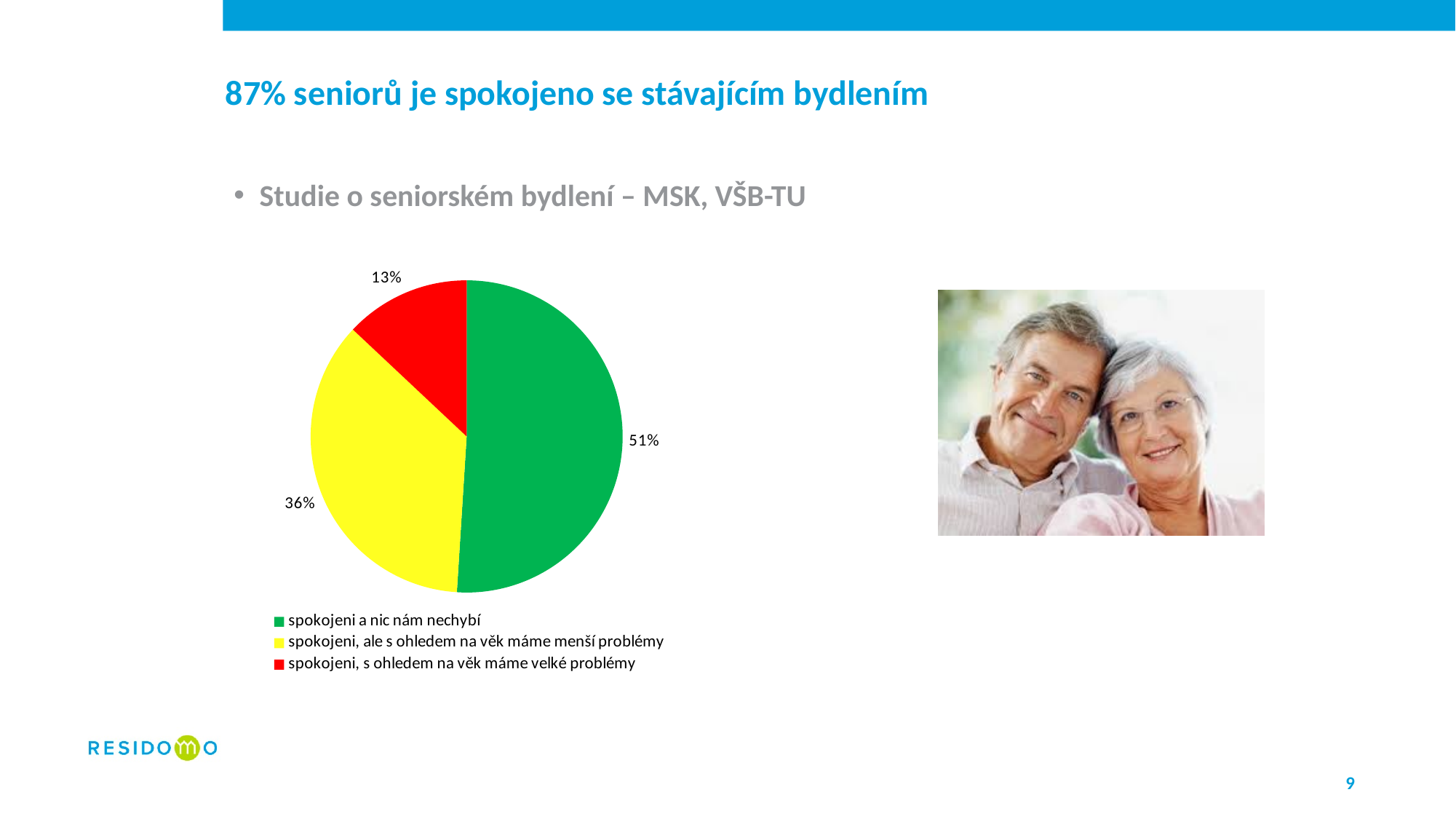
What colour is the slice for "spokojeni a nic nám nechybí"? green How many slices does the pie chart have? 3 Which category has the smallest slice of the pie? spokojeni, s ohledem na věk máme velké problémy What share of the pie is labelled "spokojeni, ale s ohledem na věk máme menší problémy"? 36% What share of the pie is labelled "spokojeni a nic nám nechybí"? 51% What is the difference in percentage points between the "spokojeni a nic nám nechybí" slice and the "spokojeni, ale s ohledem na věk máme menší problémy" slice? 15 What colour is the slice for "spokojeni, s ohledem na věk máme velké problémy"? red What kind of chart is shown on the slide? pie chart What share of the pie is labelled "spokojeni, s ohledem na věk máme velké problémy"? 13% Which slice is larger: "spokojeni, ale s ohledem na věk máme menší problémy" or "spokojeni, s ohledem na věk máme velké problémy"? spokojeni, ale s ohledem na věk máme menší problémy Which category has the largest slice of the pie? spokojeni a nic nám nechybí How many entries does the legend list? 3